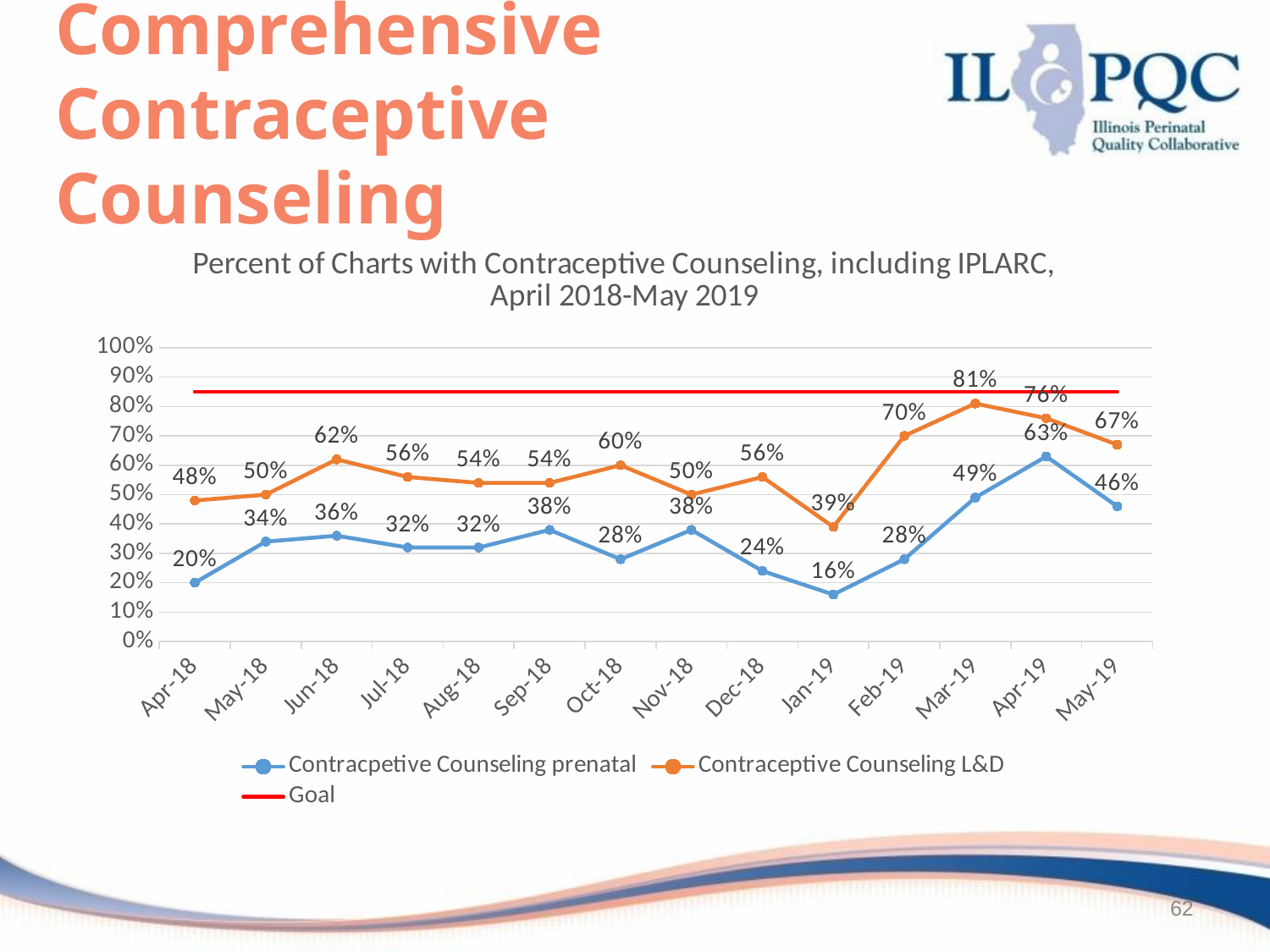
In which month is Contracpetive Counseling prenatal highest? Apr-19 In which month is Contraceptive Counseling L&D lowest? Jan-19 Which is larger in Jun-18: Contracpetive Counseling prenatal or Contraceptive Counseling L&D? Contraceptive Counseling L&D Does Contraceptive Counseling L&D rise or fall from Feb-19 to Mar-19? rise What is the value for Contraceptive Counseling L&D in Mar-19? 81% What is the value for Contracpetive Counseling prenatal in Jan-19? 16% What is the difference between Contraceptive Counseling L&D and Contracpetive Counseling prenatal in Feb-19? 42% What is the value for Contracpetive Counseling prenatal in Apr-18? 20% What kind of chart is shown? line chart Is the Goal line greater or less than 80%? greater How many series does the legend list? 3 How many months are plotted on the x axis? 14